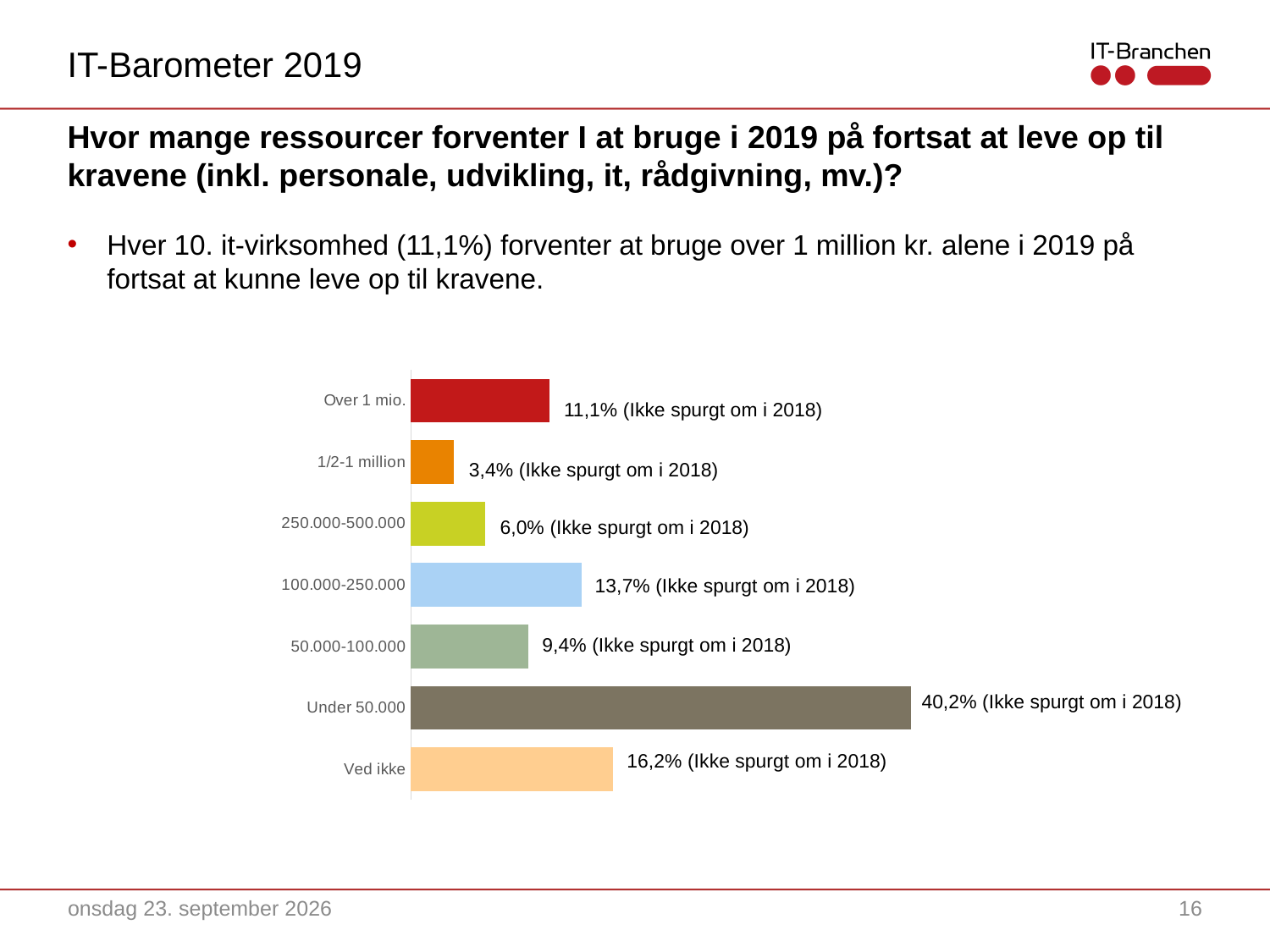
Which is larger, the value for '50.000-100.000' or the value for '250.000-500.000'? 50.000-100.000 What is the difference between the values for '100.000-250.000' and '1/2-1 million'? 10,3% What kind of chart is shown on the slide? Bar chart How many categories are shown in the chart? 7 What is the value for 'Over 1 mio.'? 11,1% What is the value for '100.000-250.000'? 13,7% What note is printed after each data label in the chart? (Ikke spurgt om i 2018) What is the value for 'Under 50.000'? 40,2% What is the value for 'Ved ikke'? 16,2% Which category has the highest value? Under 50.000 Which category has the lowest value? 1/2-1 million What is the difference between the values for 'Under 50.000' and 'Ved ikke'? 24,0%